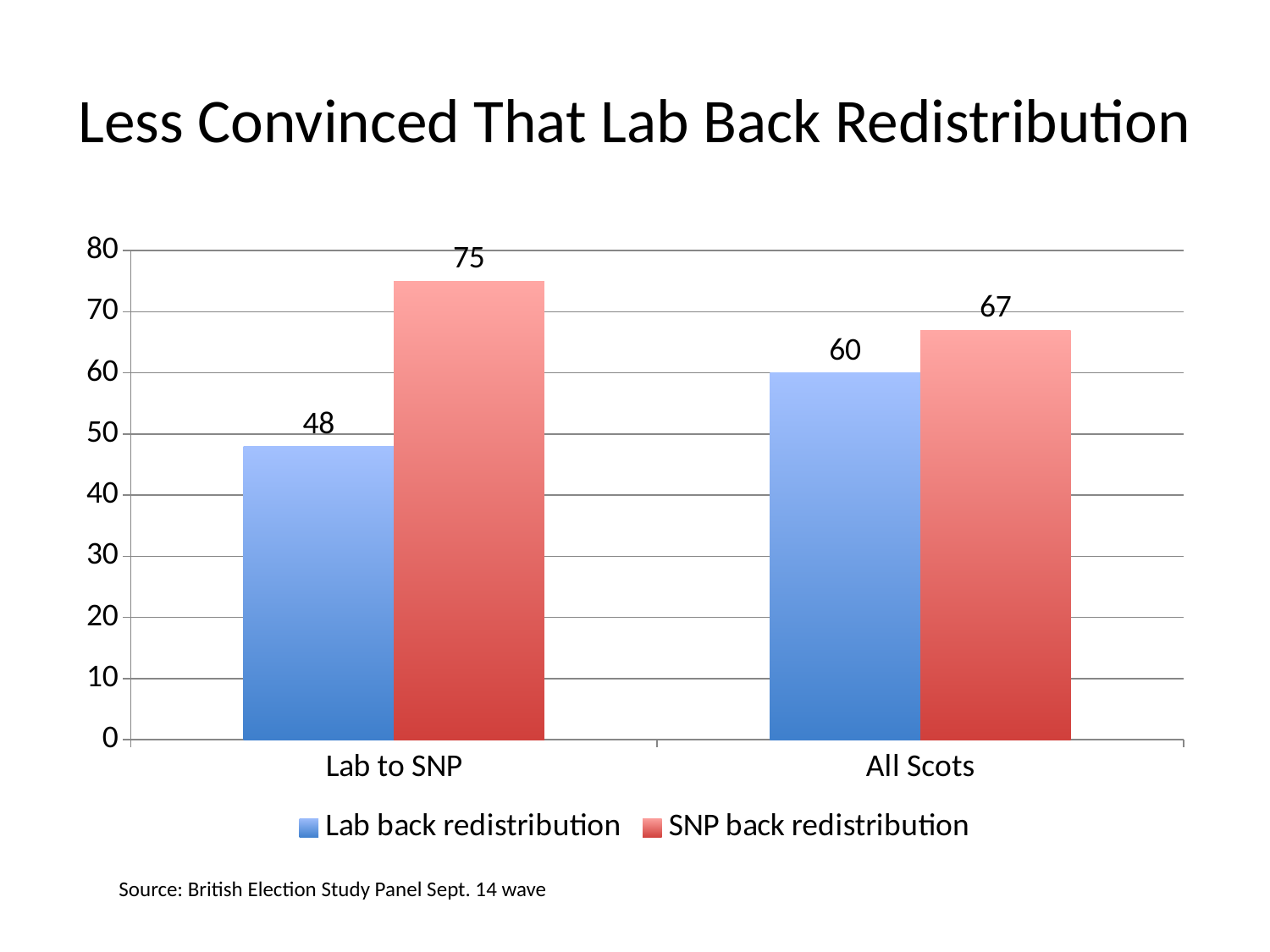
How many series does the legend list? 2 Which bar has the highest value on the chart? SNP back redistribution, Lab to SNP What is the value for SNP back redistribution in the Lab to SNP category? 75 What is the difference between SNP back redistribution and Lab back redistribution in the All Scots category? 7 What is the value for SNP back redistribution in the All Scots category? 67 How many categories are shown on the x axis? 2 What is the difference between SNP back redistribution and Lab back redistribution in the Lab to SNP category? 27 Which bar has the lowest value on the chart? Lab back redistribution, Lab to SNP What kind of chart is shown on the slide? Bar chart What is the value for Lab back redistribution in the Lab to SNP category? 48 What is the value for Lab back redistribution in the All Scots category? 60 Which is larger: Lab back redistribution for Lab to SNP or Lab back redistribution for All Scots? All Scots